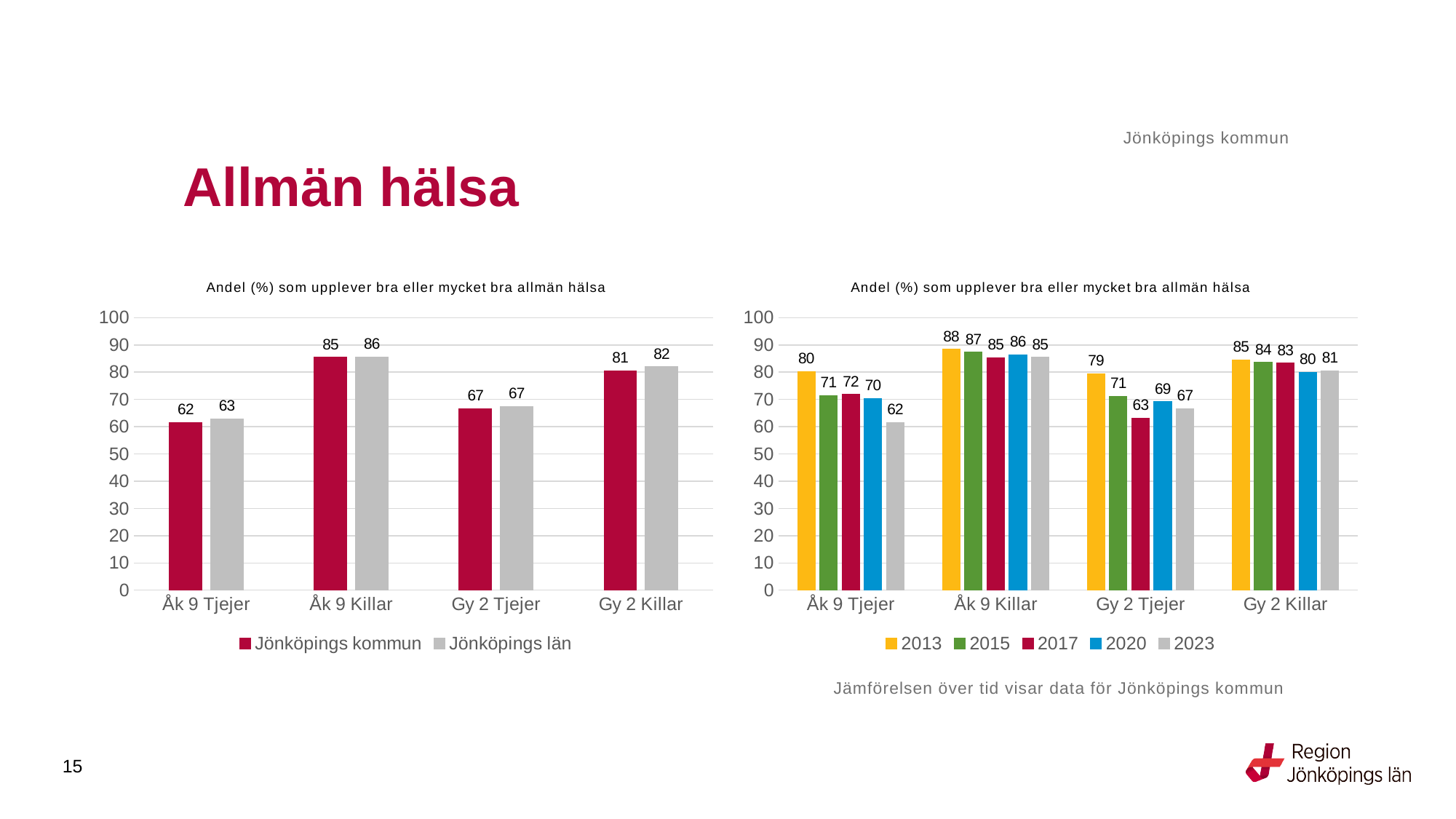
In the right chart, which year has the highest value for Åk 9 Killar? 2013 In the left chart, what is the value for Jönköpings kommun for Åk 9 Killar? 85 In the right chart, what is the value for 2013 for Åk 9 Tjejer? 80 What kind of chart is the right chart? Bar chart In the left chart, which category has the lowest value for Jönköpings kommun? Åk 9 Tjejer In the right chart, how many series does the legend list? 5 In the right chart, what is the difference between the 2013 and 2023 values for Åk 9 Tjejer? 18 In the right chart, what is the value for 2023 for Gy 2 Tjejer? 67 In the right chart, which is larger for Gy 2 Killar: the 2020 value or the 2023 value? 2023 In the left chart, what is the difference between Jönköpings län and Jönköpings kommun for Åk 9 Tjejer? 1 In the left chart, how many series does the legend list? 2 In the left chart, what is the value for Jönköpings län for Gy 2 Killar? 82